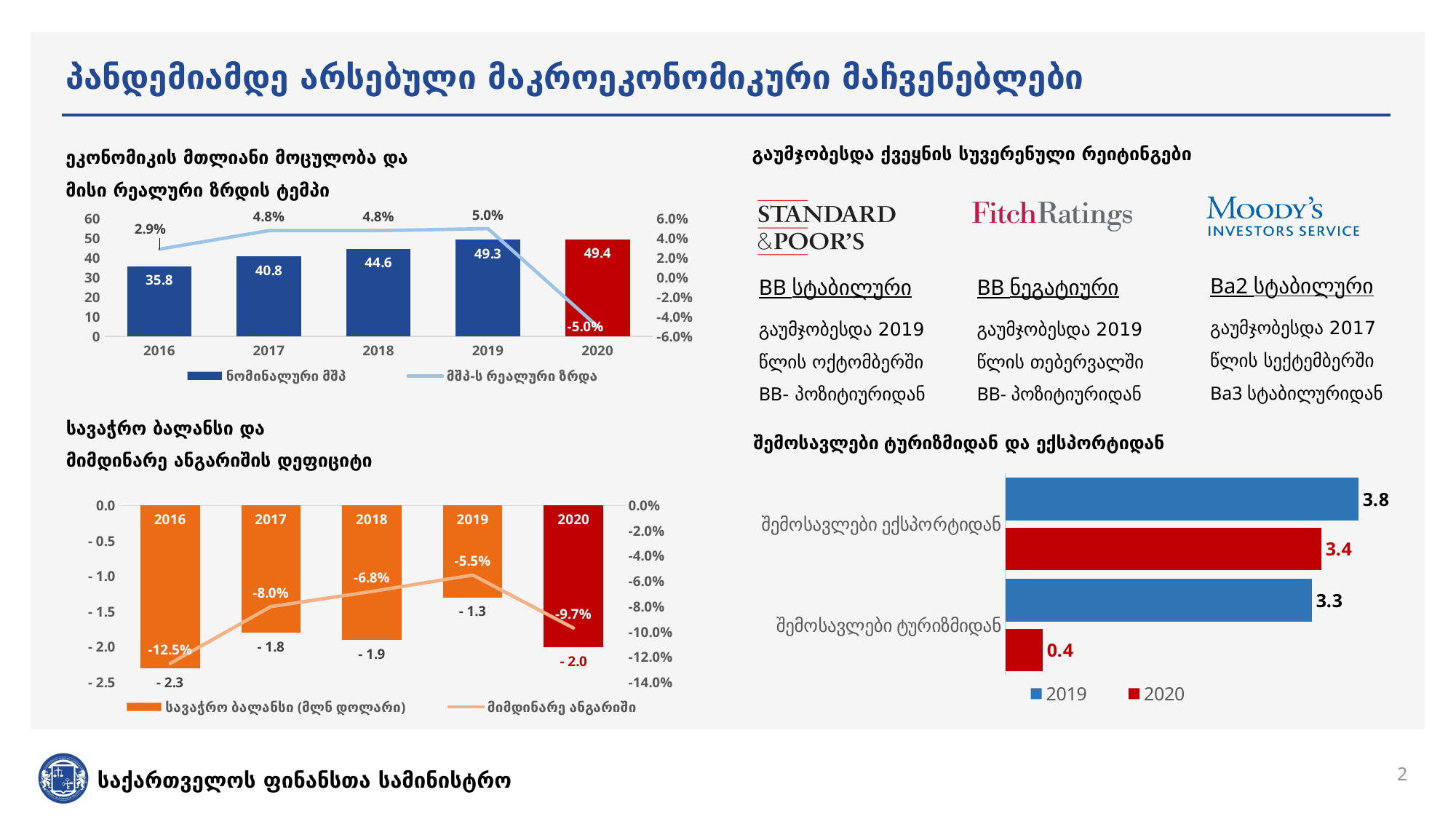
In the top-left chart, what is the nominal GDP value for 2018? 44.6 In the bottom-left chart, what is the current account deficit percentage for 2019? -5.5% In the bottom-left chart, which year has the lowest (most negative) trade balance? 2016 In the bottom-left chart, what is the trade balance value for 2017? - 1.8 In the bottom-right chart, what is the difference between the 2019 and 2020 values for export revenue (the upper category)? 0.4 In the top-left chart, how many years are shown on the x axis? 5 In the bottom-left chart, how many series does the legend list? 2 In the top-left chart, what is the real GDP growth rate shown for 2020? -5.0% In the top-left chart, which year has the highest nominal GDP bar? 2020 What type of chart is the bottom-right chart? Bar chart In the top-left chart, what is the difference between the nominal GDP values for 2019 and 2016? 13.5 In the bottom-right chart, what is the 2020 value for tourism revenue (the lower category)? 0.4